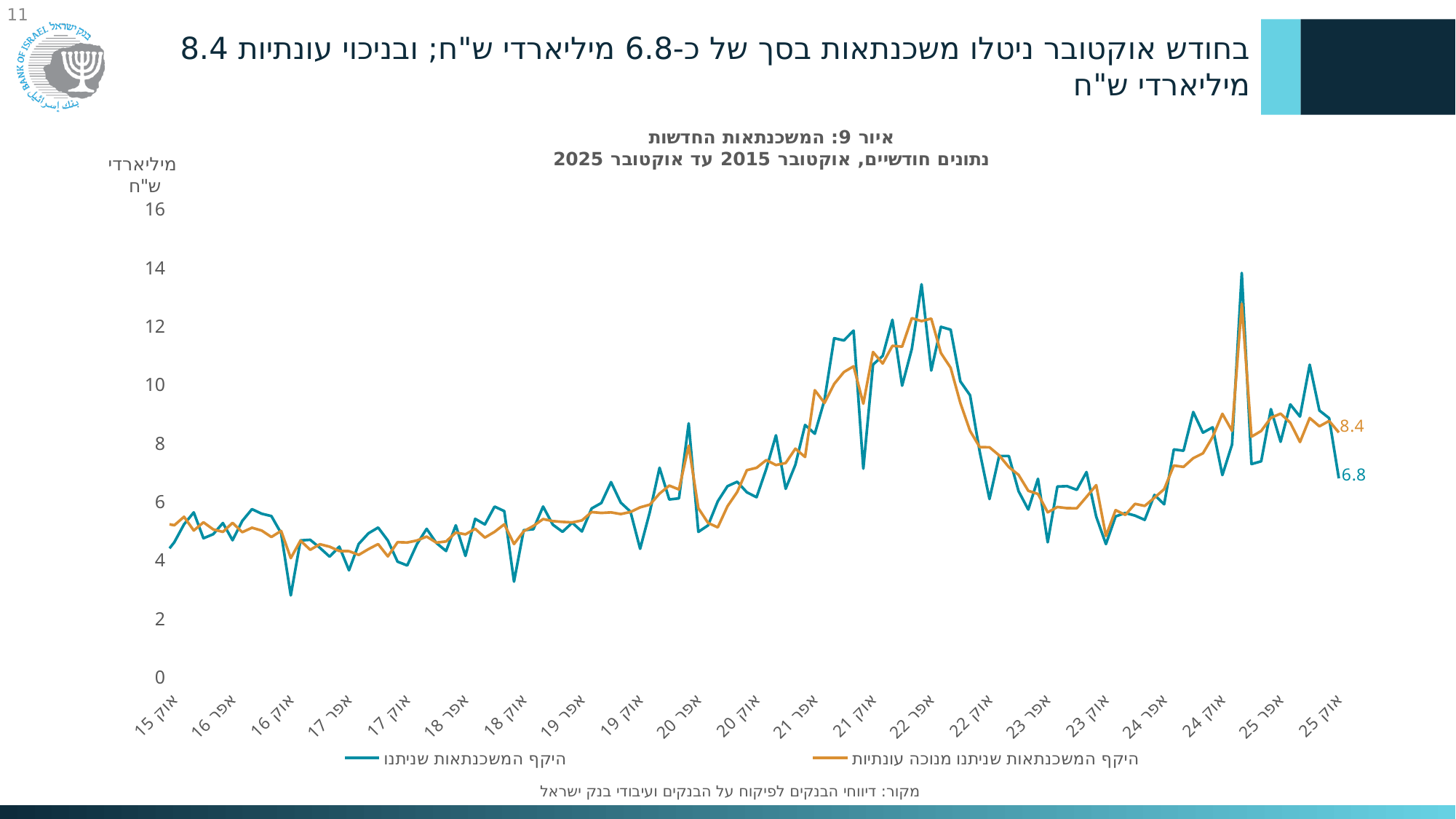
Is the value of the seasonally adjusted series (orange line) around אוק 17 greater or less than 6? less What is the unit shown on the y axis of the chart? מיליארדי ש"ח What is the value of the last data point of the seasonally adjusted series (היקף המשכנתאות שניתנו מנוכה עונתיות) in October 2025? 8.4 How many tick labels are shown on the x axis? 21 What kind of chart is shown on the slide? Line chart Between אוק 20 and אפר 22, do the values of the seasonally adjusted series generally rise or fall? rise What is the difference between the two labelled values at the end of the chart, 8.4 and 6.8? 1.6 Is the peak of the unadjusted series (teal line) around אוק 24 greater or less than 12? greater Is the value of the unadjusted series (teal line) at its dip around אוק 16 greater or less than 4? less What is the value of the last data point of the unadjusted series (היקף המשכנתאות שניתנו) in October 2025? 6.8 At the last point (October 2025), which series is higher: the seasonally adjusted series or the unadjusted series? The seasonally adjusted series (8.4) How many series does the legend list? 2